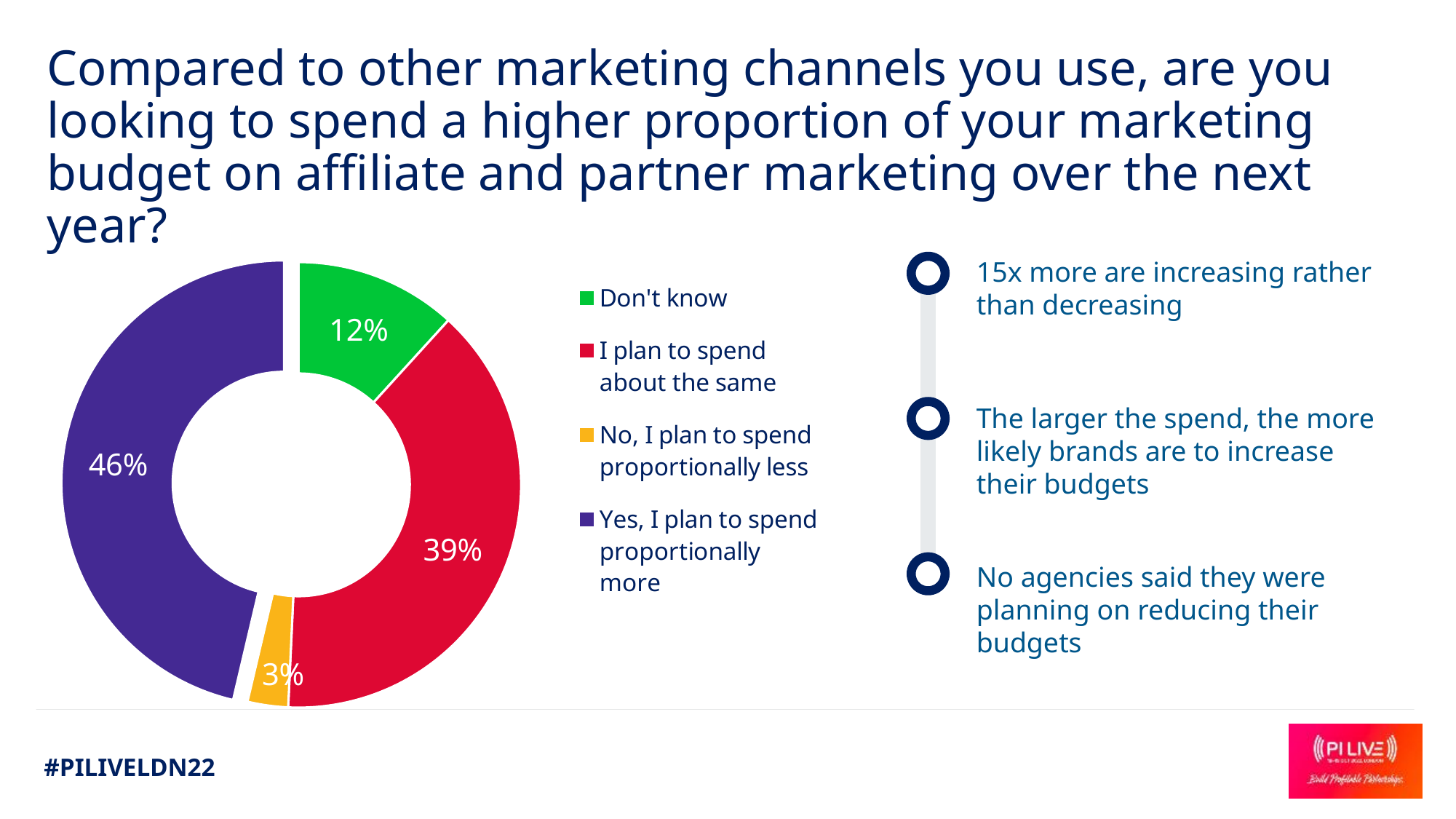
What colour represents "I plan to spend about the same" in the chart? Red What is the difference in percentage points between "Yes, I plan to spend proportionally more" and "I plan to spend about the same"? 7 What percentage of respondents said "No, I plan to spend proportionally less"? 3% Which is larger: the share for "Don't know" or the share for "No, I plan to spend proportionally less"? Don't know What percentage of respondents said "I plan to spend about the same"? 39% How many response categories are shown in the chart? 4 What kind of chart is shown on the slide? Pie chart (doughnut) Which response has the smallest share of the chart? No, I plan to spend proportionally less Which response has the largest share of the chart? Yes, I plan to spend proportionally more What percentage of respondents answered "Don't know"? 12% What colour represents "Don't know" in the chart? Green What percentage of respondents said "Yes, I plan to spend proportionally more"? 46%